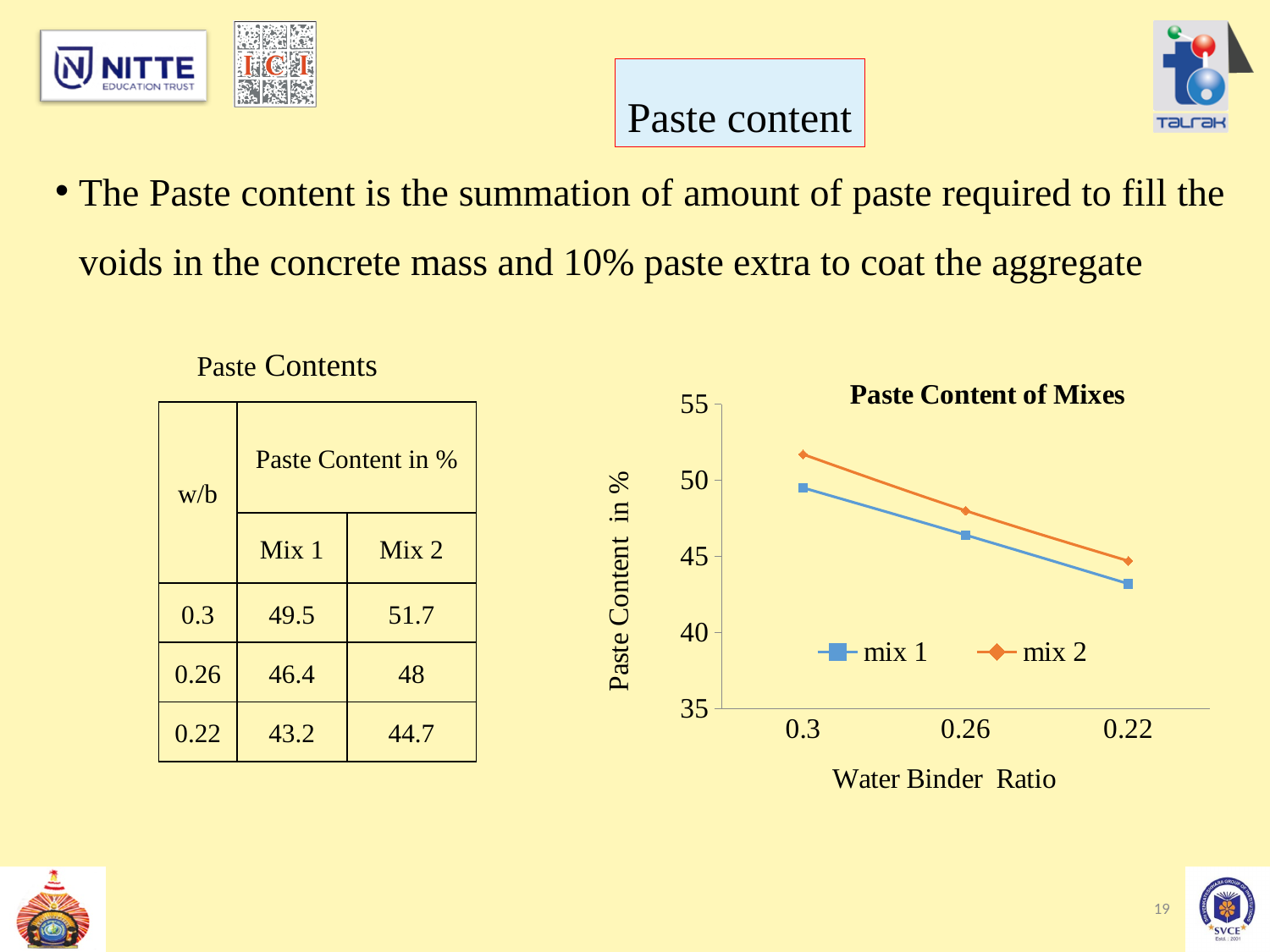
What is the paste content of mix 2 at a water binder ratio of 0.26? 48 Do the paste content values rise or fall along the x axis from 0.3 to 0.22 in the "Paste Content of Mixes" chart? fall Is the paste content of mix 1 at a water binder ratio of 0.22 greater or less than 45? less What is the difference between the paste content of mix 2 and mix 1 at a water binder ratio of 0.3? 2.2 At which water binder ratio is the paste content of mix 2 highest? 0.3 What is the paste content of mix 1 at a water binder ratio of 0.3? 49.5 What kind of chart is "Paste Content of Mixes"? line chart At which water binder ratio is the paste content of mix 1 lowest? 0.22 How many series does the legend of the "Paste Content of Mixes" chart list? 2 Which series has the higher paste content at a water binder ratio of 0.3, mix 1 or mix 2? mix 2 What is the paste content of mix 2 at a water binder ratio of 0.22? 44.7 How many water binder ratio values are plotted on the x axis of the "Paste Content of Mixes" chart? 3